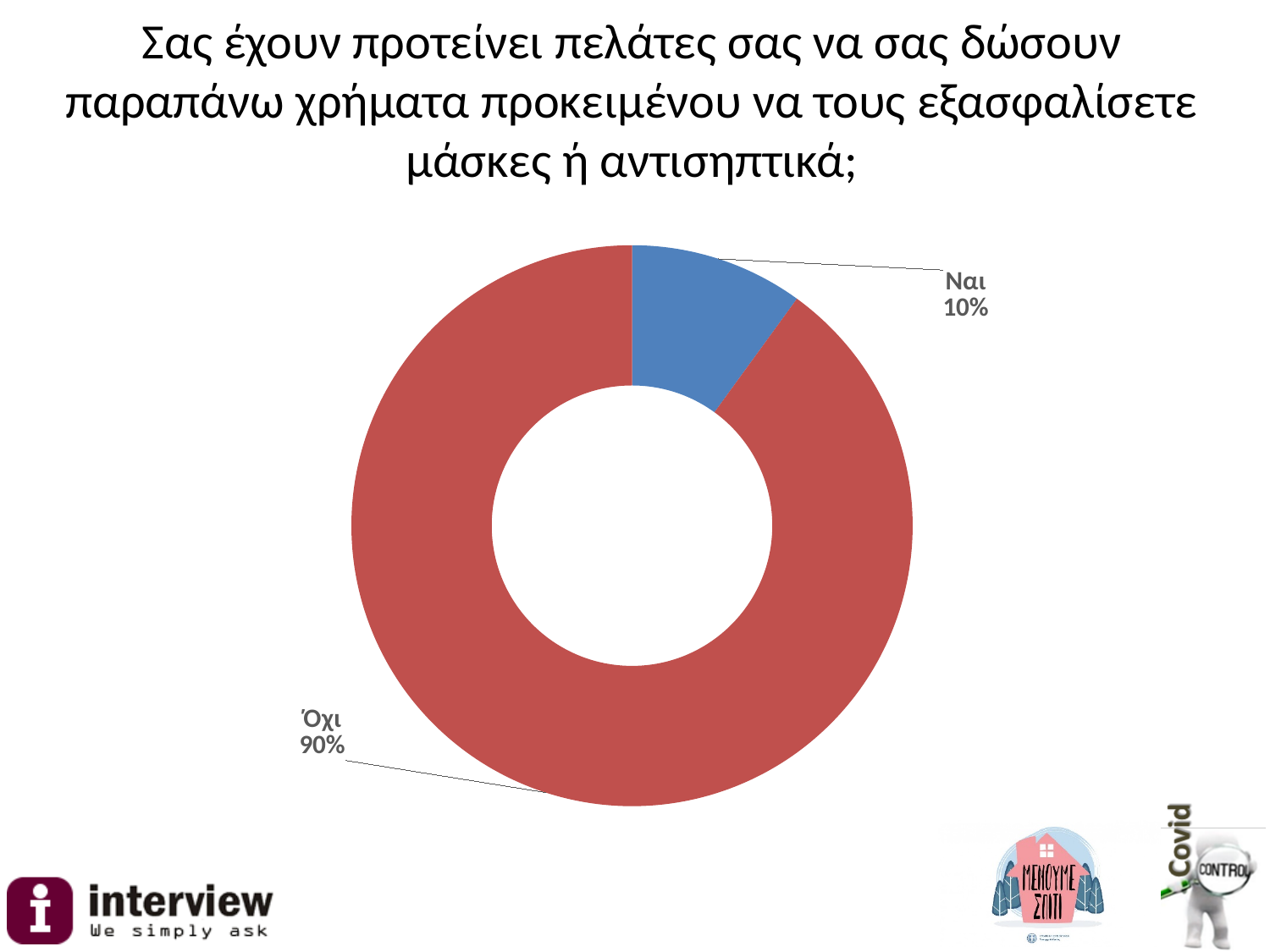
What colour is the Ναι slice? Blue What is the difference in percentage points between Όχι and Ναι? 80 What kind of chart is shown on the slide? Doughnut (pie) chart What colour is the Όχι slice? Red What percentage of respondents answered Ναι? 10% Which is larger, the share for Ναι or the share for Όχι? Όχι How many categories are shown in the chart? 2 What percentage of respondents answered Όχι? 90% What share of the chart does the Όχι slice represent? 90% Which answer has the smallest share of the chart? Ναι Which answer has the largest share of the chart? Όχι